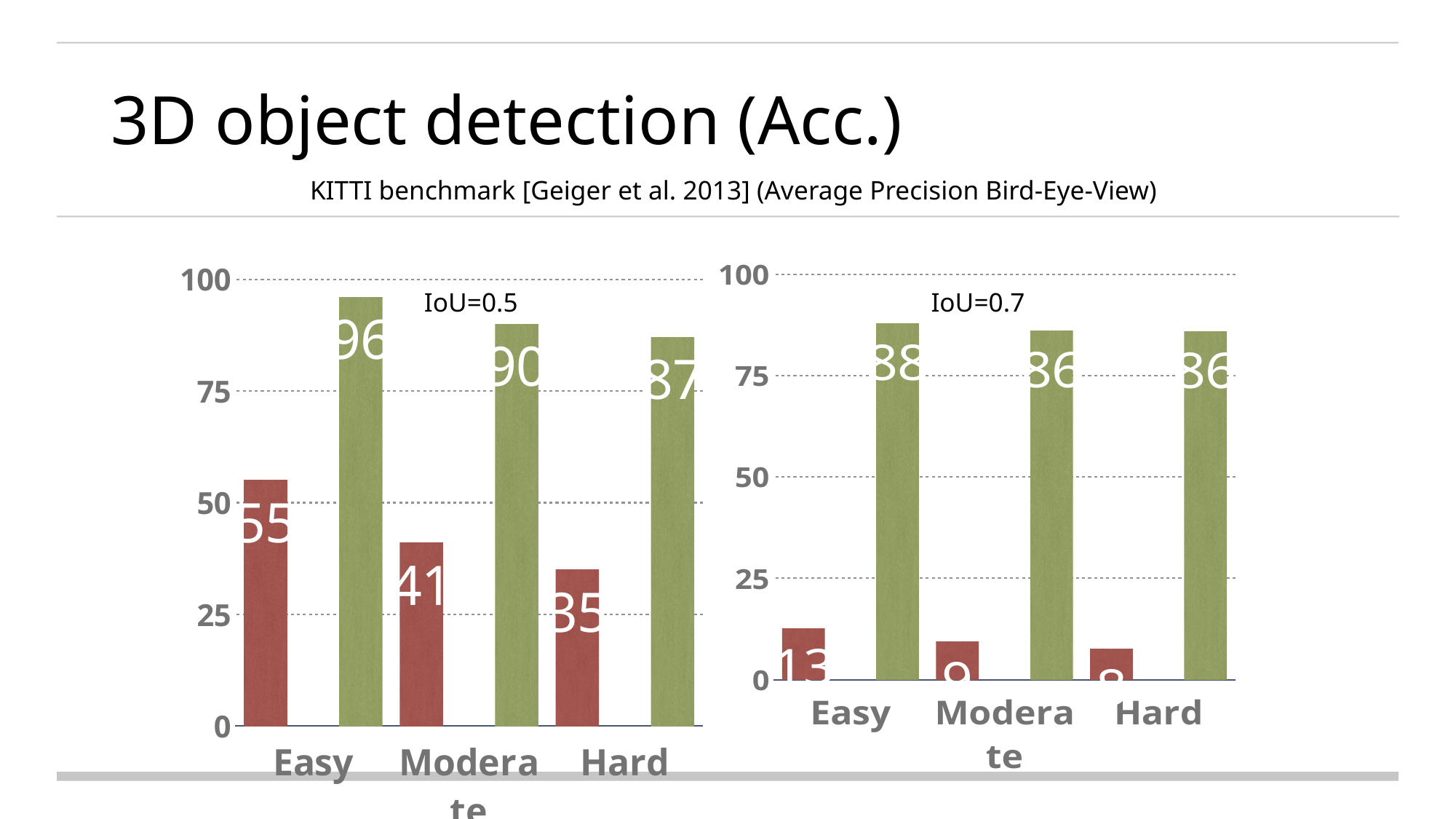
In the IoU=0.5 chart, what is the value of the red bar for Hard? 35 In the IoU=0.5 chart, what is the difference between the green and red bars for Easy? 41 In the IoU=0.7 chart, what is the value of the green bar for Easy? 88 In the IoU=0.5 chart, which category has the lowest green bar? Hard In the IoU=0.5 chart, which category has the highest red bar? Easy In the IoU=0.5 chart, what is the value of the red bar for Moderate? 41 In the IoU=0.5 chart, what is the value of the green bar for Easy? 96 In the IoU=0.5 chart, do the red bar values rise or fall from Easy to Hard? fall How many categories are shown on the x axis of the IoU=0.7 chart? 3 What type of chart is the IoU=0.5 chart? bar chart In the IoU=0.7 chart, is the red bar for Moderate greater or less than 25? less In the IoU=0.7 chart, what is the value of the red bar for Easy? 13